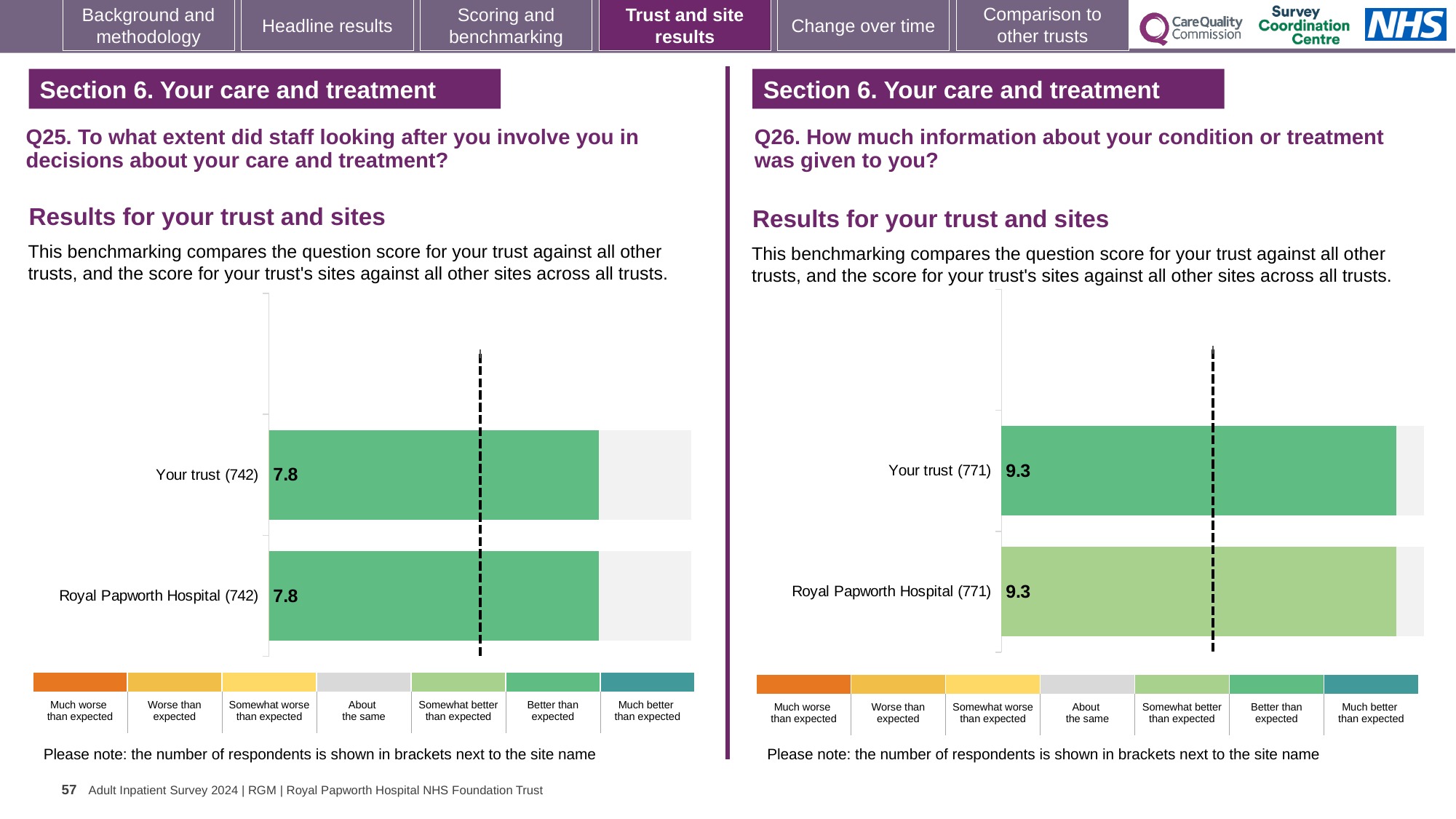
What kind of chart is the Q25 chart on the left? Bar chart In the Q26 chart on the right, how many respondents are shown in brackets next to Royal Papworth Hospital? 771 In the Q26 chart on the right, which benchmark category does the colour of the Royal Papworth Hospital bar correspond to in the legend? Somewhat better than expected How many bars are plotted in the Q26 chart on the right? 2 In the Q26 chart on the right, what is the score for Royal Papworth Hospital? 9.3 How many bars are plotted in the Q25 chart on the left? 2 In the Q25 chart on the left, what is the difference between the score for Your trust and the score for Royal Papworth Hospital? 0.0 In the Q25 chart on the left, what is the score for Royal Papworth Hospital? 7.8 In the Q25 chart on the left, how many respondents are shown in brackets next to Your trust? 742 In the Q25 chart on the left, what is the score for Your trust? 7.8 In the Q26 chart on the right, what is the difference between the score for Your trust and the score for Royal Papworth Hospital? 0.0 In the Q26 chart on the right, what is the score for Your trust? 9.3